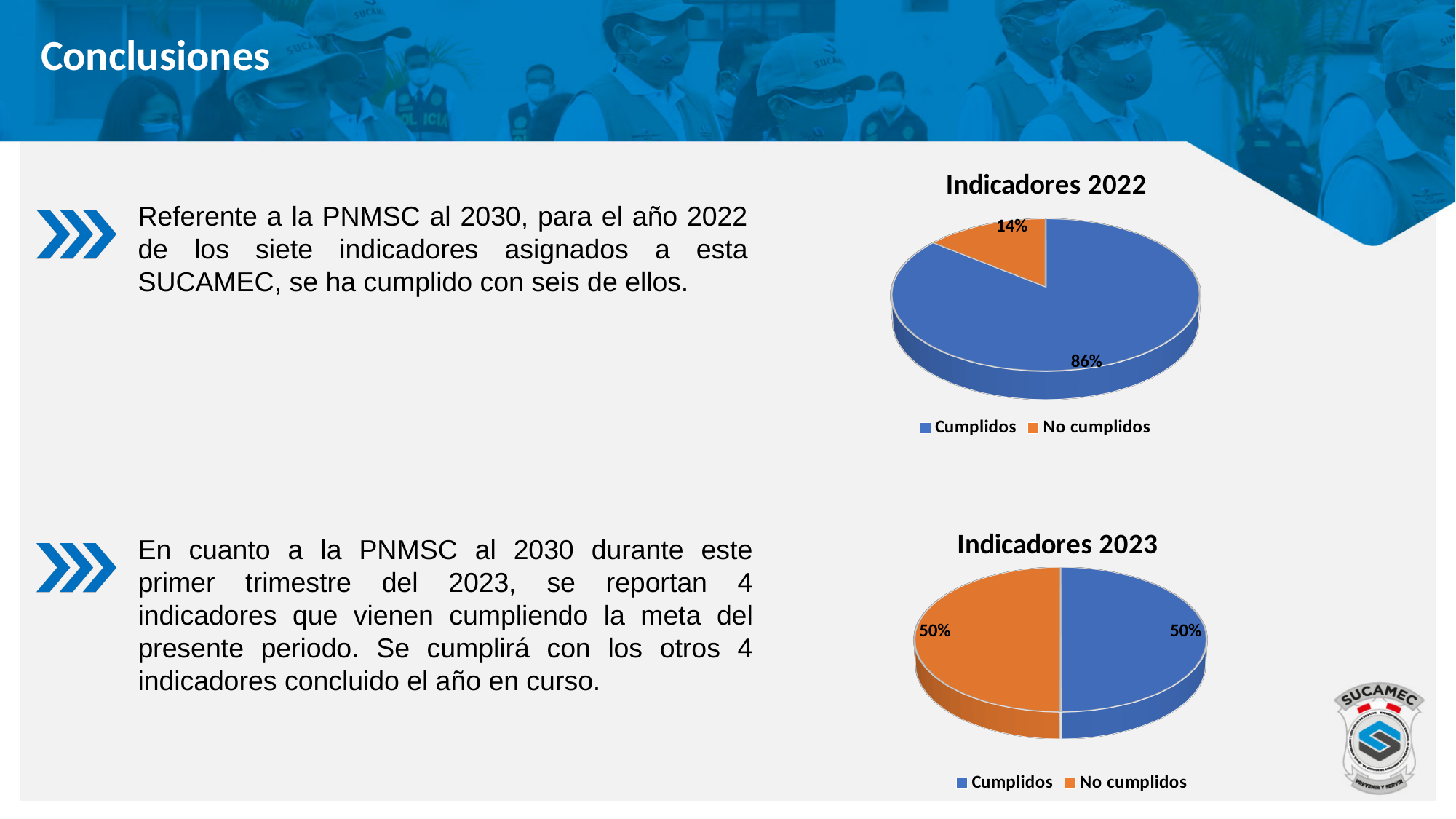
What kind of chart is 'Indicadores 2023'? Pie chart How many entries does the legend of the 'Indicadores 2023' chart list? 2 In the 'Indicadores 2022' chart, what is the difference between the 'Cumplidos' and 'No cumplidos' shares? 72% In the 'Indicadores 2022' chart, which category has the largest slice? Cumplidos In the 'Indicadores 2022' chart, which is larger, 'Cumplidos' or 'No cumplidos'? Cumplidos In the 'Indicadores 2022' chart, what share of the pie is 'Cumplidos'? 86% How many categories does the 'Indicadores 2022' chart show? 2 In the 'Indicadores 2022' chart, what share of the pie is 'No cumplidos'? 14% In the 'Indicadores 2022' chart, which category has the smallest slice? No cumplidos In the 'Indicadores 2022' chart, what colour is the 'No cumplidos' slice? Orange In the 'Indicadores 2023' chart, what share of the pie is 'Cumplidos'? 50%